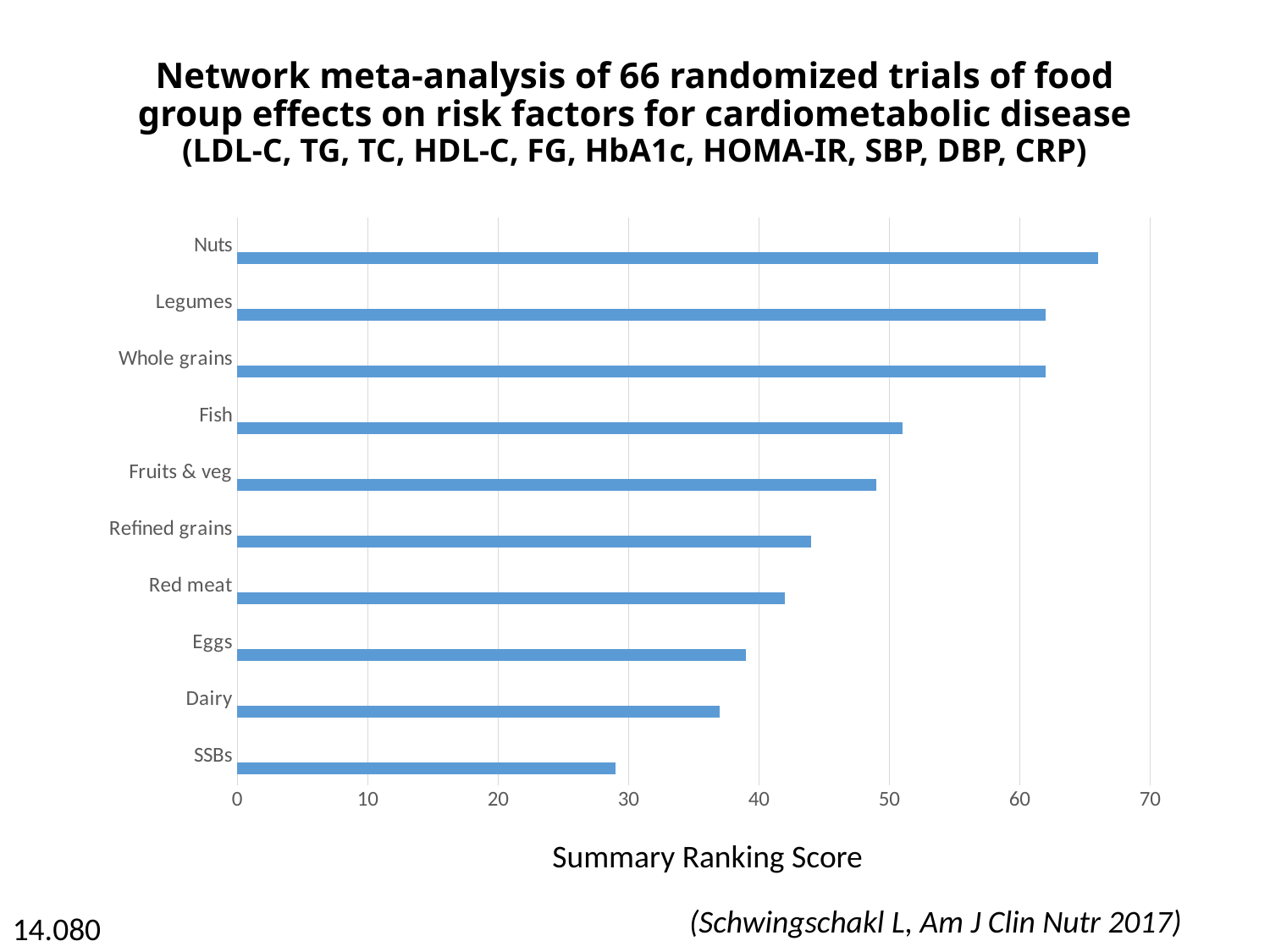
Is the Summary Ranking Score for Dairy greater or less than 40? less What kind of chart is shown on the slide? bar chart What is the label on the horizontal axis of the chart? Summary Ranking Score Which food group has the highest Summary Ranking Score? Nuts How many randomized trials does the chart title say were included in the network meta-analysis? 66 Is the Summary Ranking Score for Nuts greater or less than 60? greater Which has a higher Summary Ranking Score, Red meat or Legumes? Legumes Is the Summary Ranking Score for SSBs greater or less than 30? less Which food group has the lowest Summary Ranking Score? SSBs Which has a higher Summary Ranking Score, Fish or Dairy? Fish How many food groups are plotted on the chart? 10